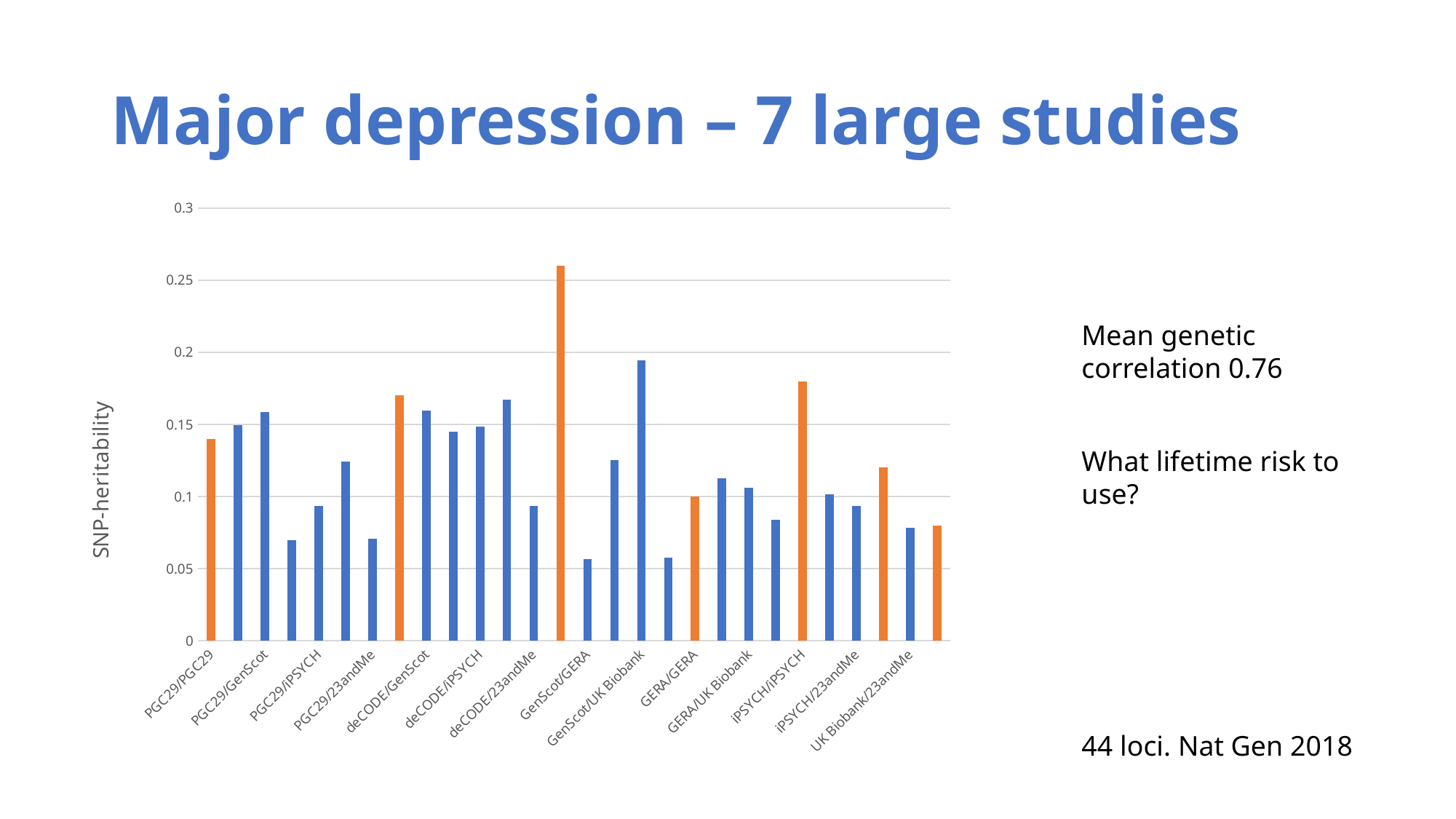
What is the label on the vertical axis of the chart? SNP-heritability Is the value for UK Biobank/23andMe greater or less than 0.1? less Which has the larger SNP-heritability, PGC29/PGC29 or iPSYCH/iPSYCH? iPSYCH/iPSYCH How many bars are plotted in the chart? 28 What kind of chart is shown on the slide? bar chart What is the highest value shown on the vertical axis of the chart? 0.3 Is the value for iPSYCH/iPSYCH greater or less than 0.15? greater Is the value for PGC29/PGC29 greater or less than 0.15? less Which has the larger SNP-heritability, GenScot/UK Biobank or GERA/UK Biobank? GenScot/UK Biobank